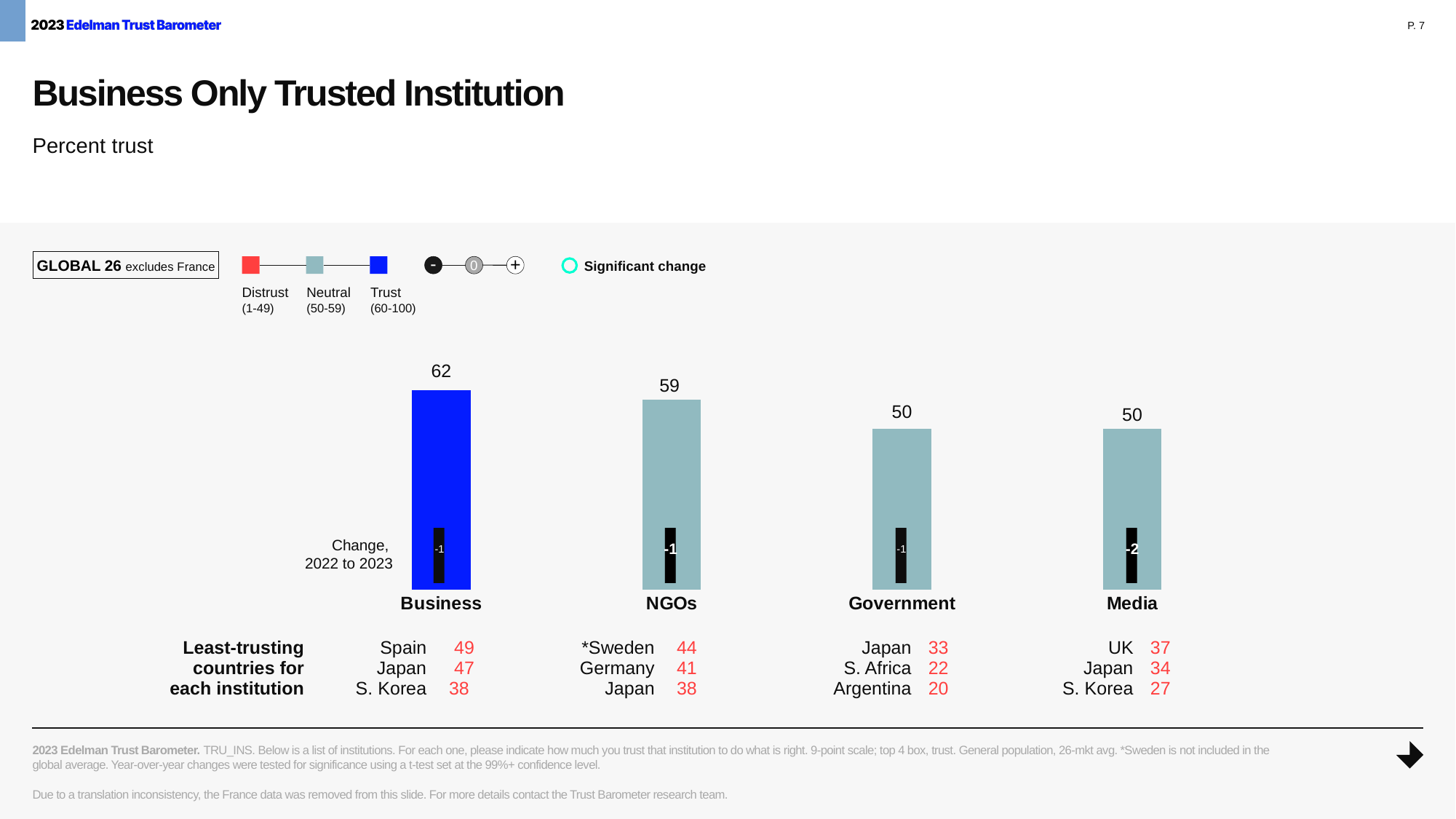
Do the percent trust values rise or fall from Business to Media along the x axis? Fall How many institutions are plotted in the chart? 4 What is the percent trust value for Government? 50 Which institution's bar is coloured blue (Trust, 60-100)? Business Which has a higher percent trust, NGOs or Government? NGOs Which institution has the highest percent trust? Business What is the percent trust value for Business? 62 What is the change from 2022 to 2023 shown for Media? -2 What is the difference in percent trust between Business and Media? 12 What kind of chart is shown on the slide? Bar chart What is the percent trust value for NGOs? 59 What is the difference in percent trust between Business and NGOs? 3